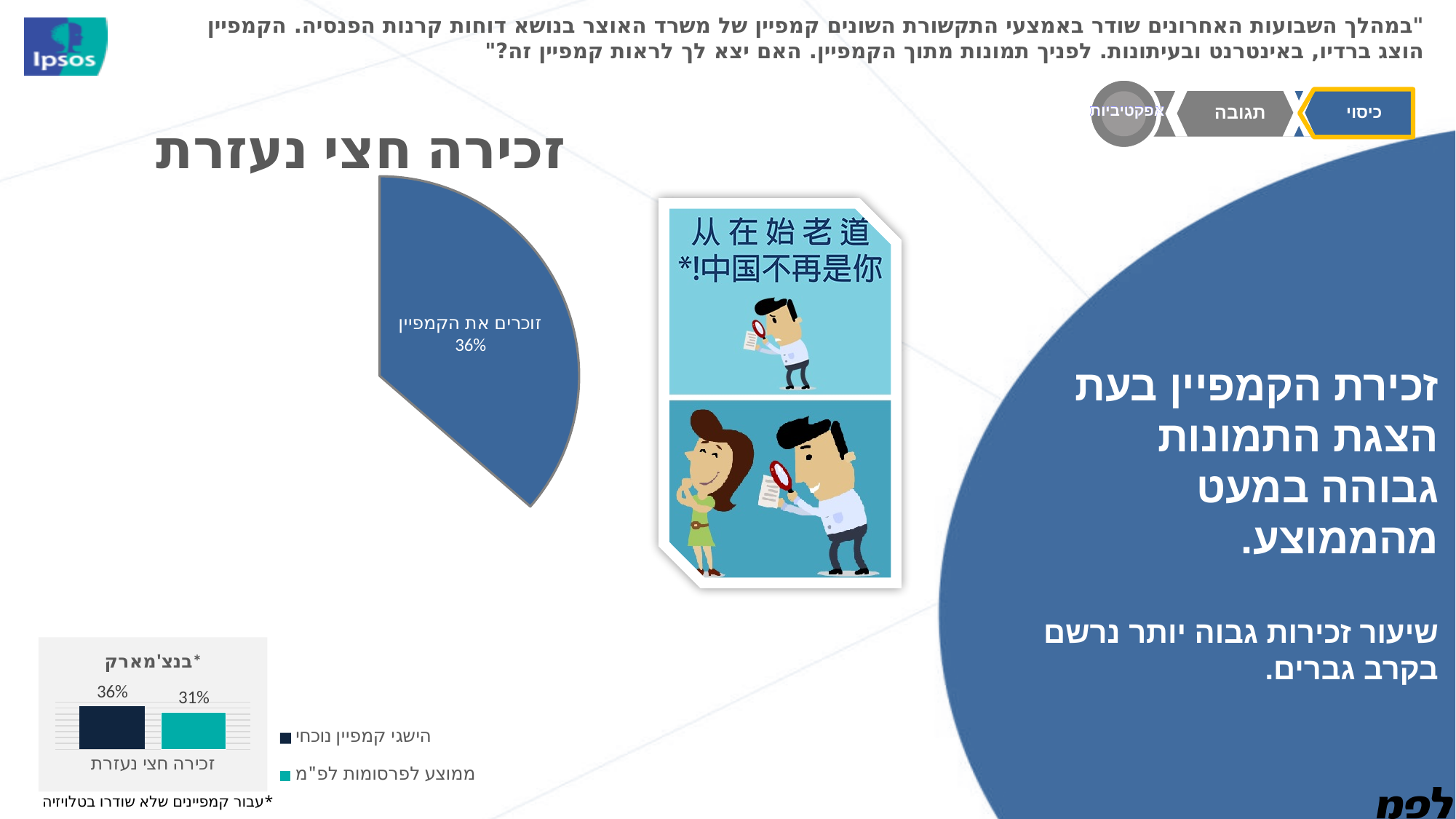
In the "בנצ'מארק*" chart, what colour is the bar for "ממוצע לפרסומות לפ"מ"? teal In the "בנצ'מארק*" chart at the bottom left, what is the value for "הישגי קמפיין נוכחי"? 36% What is the category label on the x axis of the "בנצ'מארק*" chart? זכירה חצי נעזרת In the "בנצ'מארק*" chart, is the value for "הישגי קמפיין נוכחי" larger or smaller than the value for "ממוצע לפרסומות לפ"מ"? larger What kind of chart is the "בנצ'מארק*" chart at the bottom left of the slide? bar chart How many series does the legend of the "בנצ'מארק*" chart list? 2 In the "בנצ'מארק*" chart at the bottom left, what is the value for "ממוצע לפרסומות לפ"מ"? 31% In the "בנצ'מארק*" chart, which series has the higher value? הישגי קמפיין נוכחי In the "בנצ'מארק*" chart, what is the difference between "הישגי קמפיין נוכחי" and "ממוצע לפרסומות לפ"מ"? 5% What kind of chart is the large chart in the middle-left of the slide labelled "זוכרים את הקמפיין"? pie chart In the pie chart under the title "זכירה חצי נעזרת", what percentage is shown for "זוכרים את הקמפיין"? 36% In the "בנצ'מארק*" chart, which series has the lower value? ממוצע לפרסומות לפ"מ